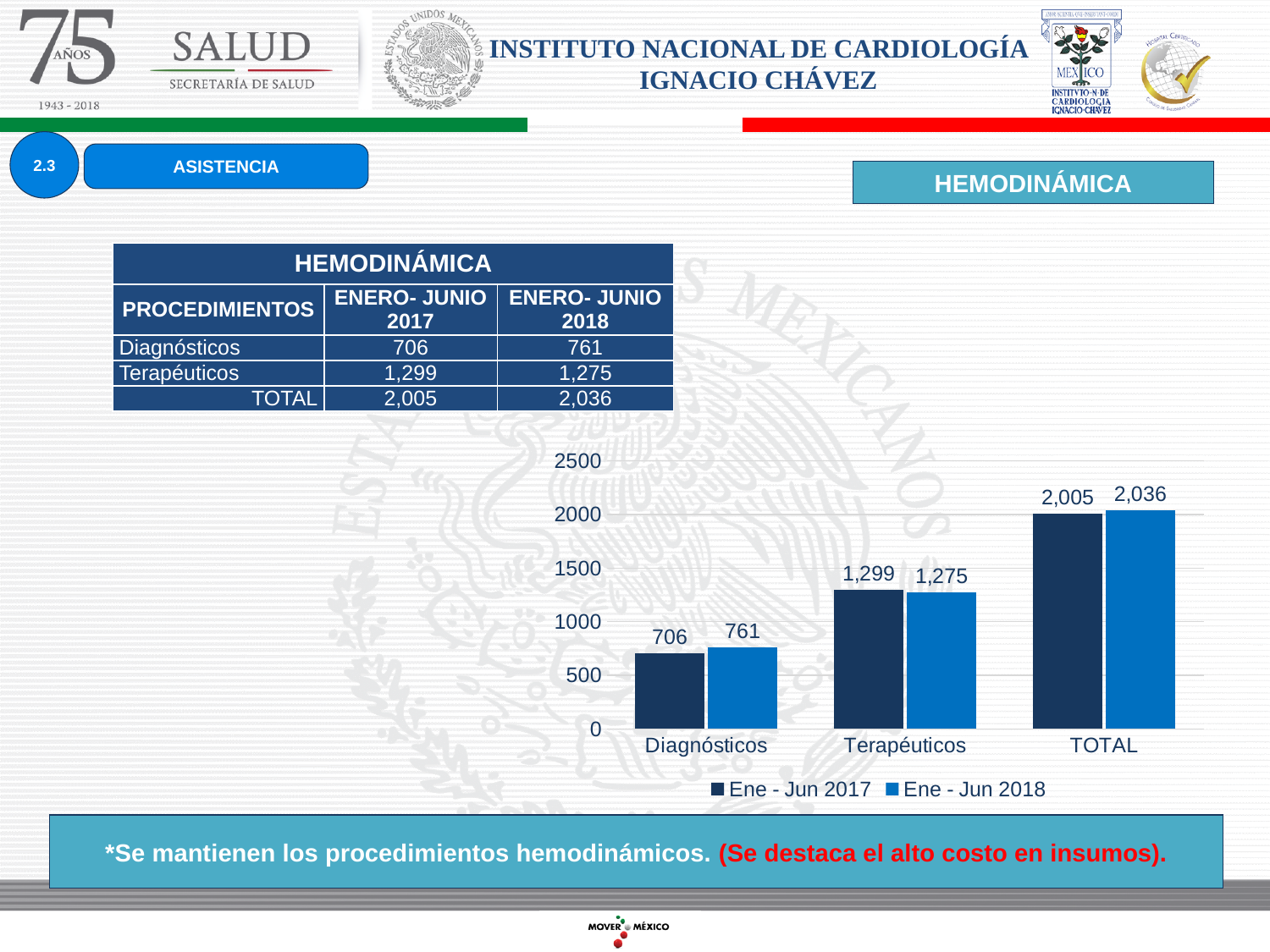
How many categories are shown on the x axis of the chart? 3 What is the value for Terapéuticos in the Ene - Jun 2018 series? 1,275 What is the TOTAL value for Ene - Jun 2018? 2,036 What are the two series names listed in the legend? Ene - Jun 2017 and Ene - Jun 2018 What is the difference between the Ene - Jun 2017 and Ene - Jun 2018 values for Terapéuticos? 24 What is the difference between the Ene - Jun 2018 and Ene - Jun 2017 values for Diagnósticos? 55 What is the value for Diagnósticos in the Ene - Jun 2017 series? 706 Which category has the lowest value in the Ene - Jun 2017 series? Diagnósticos How many series does the legend list? 2 Is the value for Diagnósticos in Ene - Jun 2018 greater or less than 1000? less Which is larger for Terapéuticos: Ene - Jun 2017 or Ene - Jun 2018? Ene - Jun 2017 What kind of chart is shown on the slide? bar chart